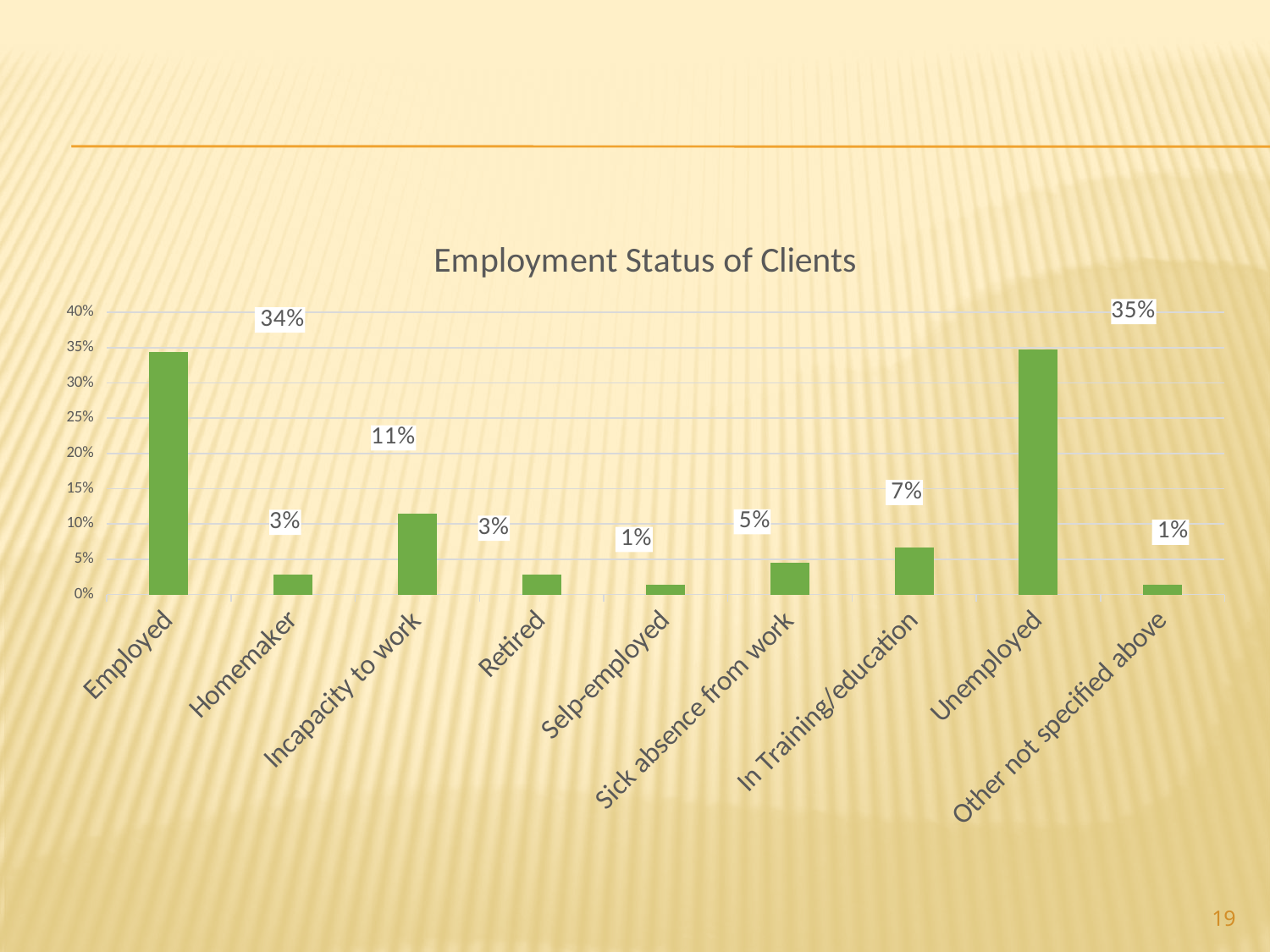
What kind of chart is shown on the slide? Bar chart What is the value for Unemployed? 35% What is the difference between the values for Incapacity to work and In Training/education? 4% What is the value for Employed? 34% Is the value for Incapacity to work greater or less than 10%? greater Which is larger, the value for Homemaker or the value for Sick absence from work? Sick absence from work What is the value for Sick absence from work? 5% What is the value for Incapacity to work? 11% What is the value for In Training/education? 7% What is the difference between the values for Unemployed and Employed? 1% Which category has the highest value? Unemployed How many categories are shown on the x axis? 9